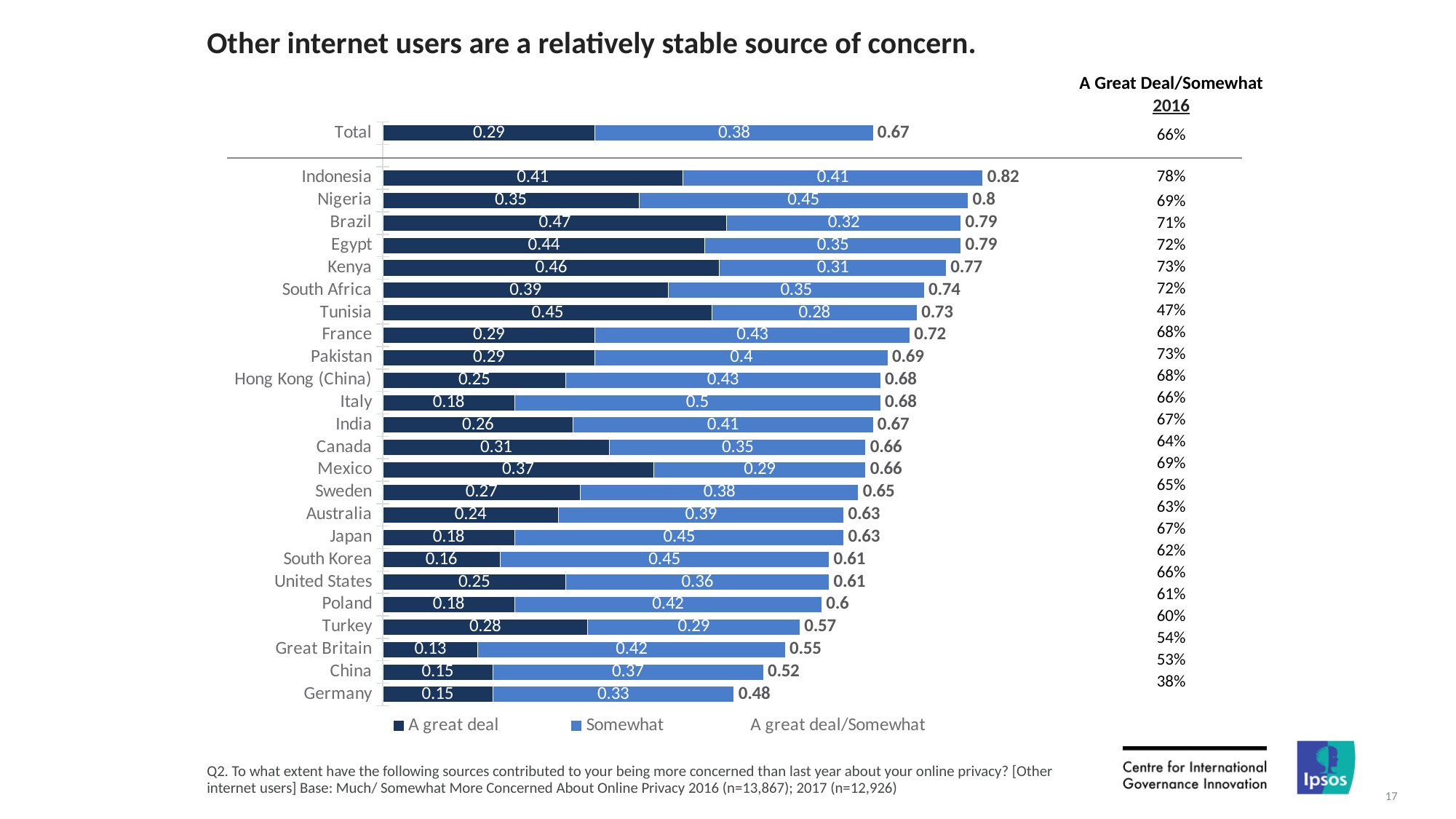
Which is larger, the 'A great deal' value for Mexico or for Canada? Mexico What is the 'A great deal' value for Brazil? 0.47 What is the 'A Great Deal/Somewhat 2016' value shown for Tunisia? 47% What is the difference between the 'Somewhat' values for Nigeria and Brazil? 0.13 What is the combined 'A great deal/Somewhat' value for Indonesia? 0.82 How many series does the legend list? 3 Which country has the lowest combined 'A great deal/Somewhat' value? Germany Which country has the highest 'A great deal' value? Brazil What is the title of the slide? Other internet users are a relatively stable source of concern. What is the 'Somewhat' value for Italy? 0.5 What kind of chart is shown on the slide? Stacked bar chart What is the total of the stacked bar for Turkey? 0.57